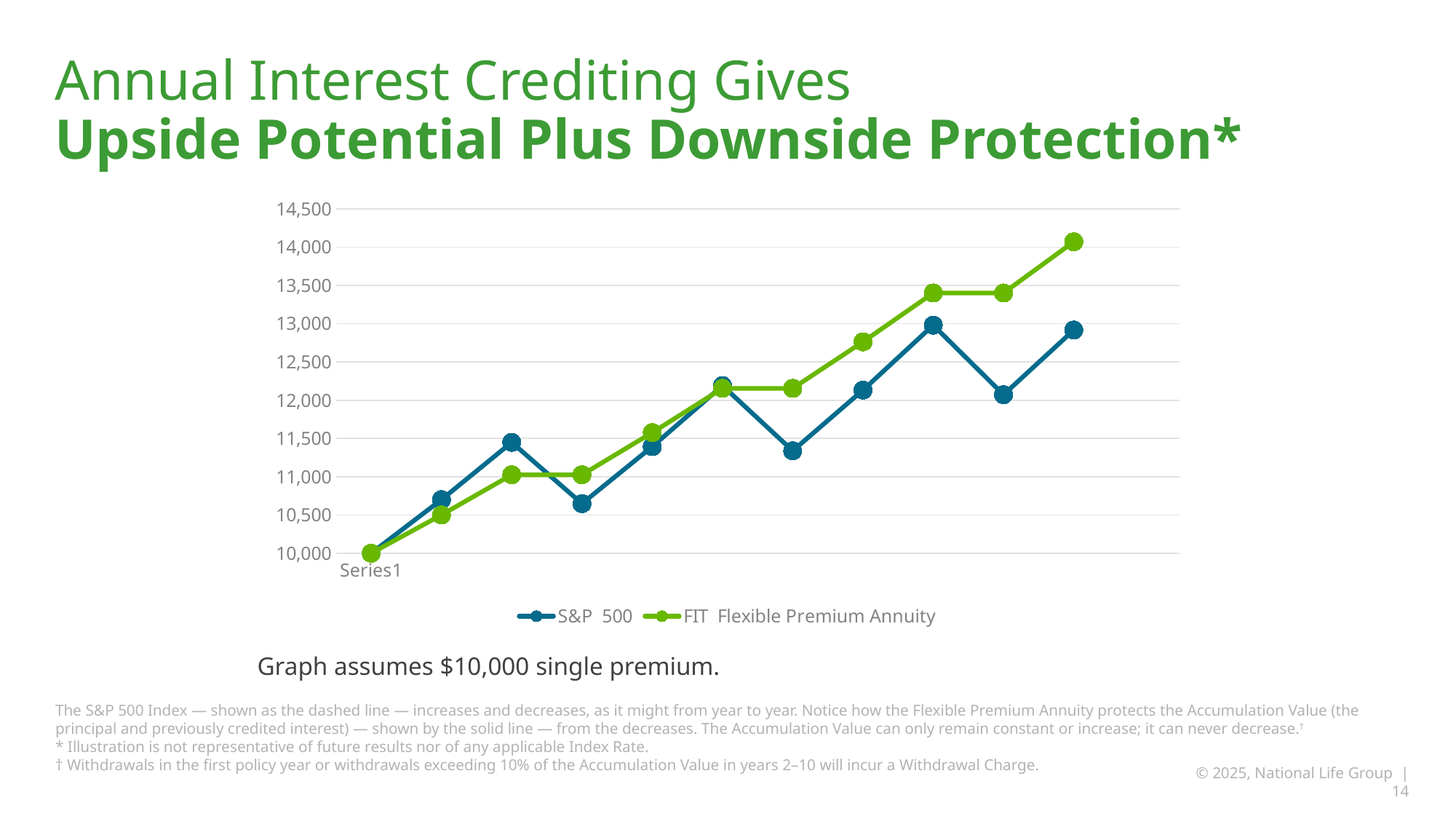
Which series reaches the highest value on the chart? FIT Flexible Premium Annuity Does the FIT Flexible Premium Annuity line ever decrease from one point to the next? No How many series does the legend list? 2 What colour is the S&P 500 line? blue How many data points does each line have? 11 What is the starting value of the S&P 500 line at Series1? 10,000 What are the two series named in the legend? S&P 500 and FIT Flexible Premium Annuity What kind of chart is shown on the slide? line chart Does the S&P 500 line rise steadily, or does it rise and fall along the x axis? rises and falls Is the final value of the FIT Flexible Premium Annuity line greater or less than 13,500? greater What is the starting value of the FIT Flexible Premium Annuity line at Series1? 10,000 At the final point, which series is higher, S&P 500 or FIT Flexible Premium Annuity? FIT Flexible Premium Annuity